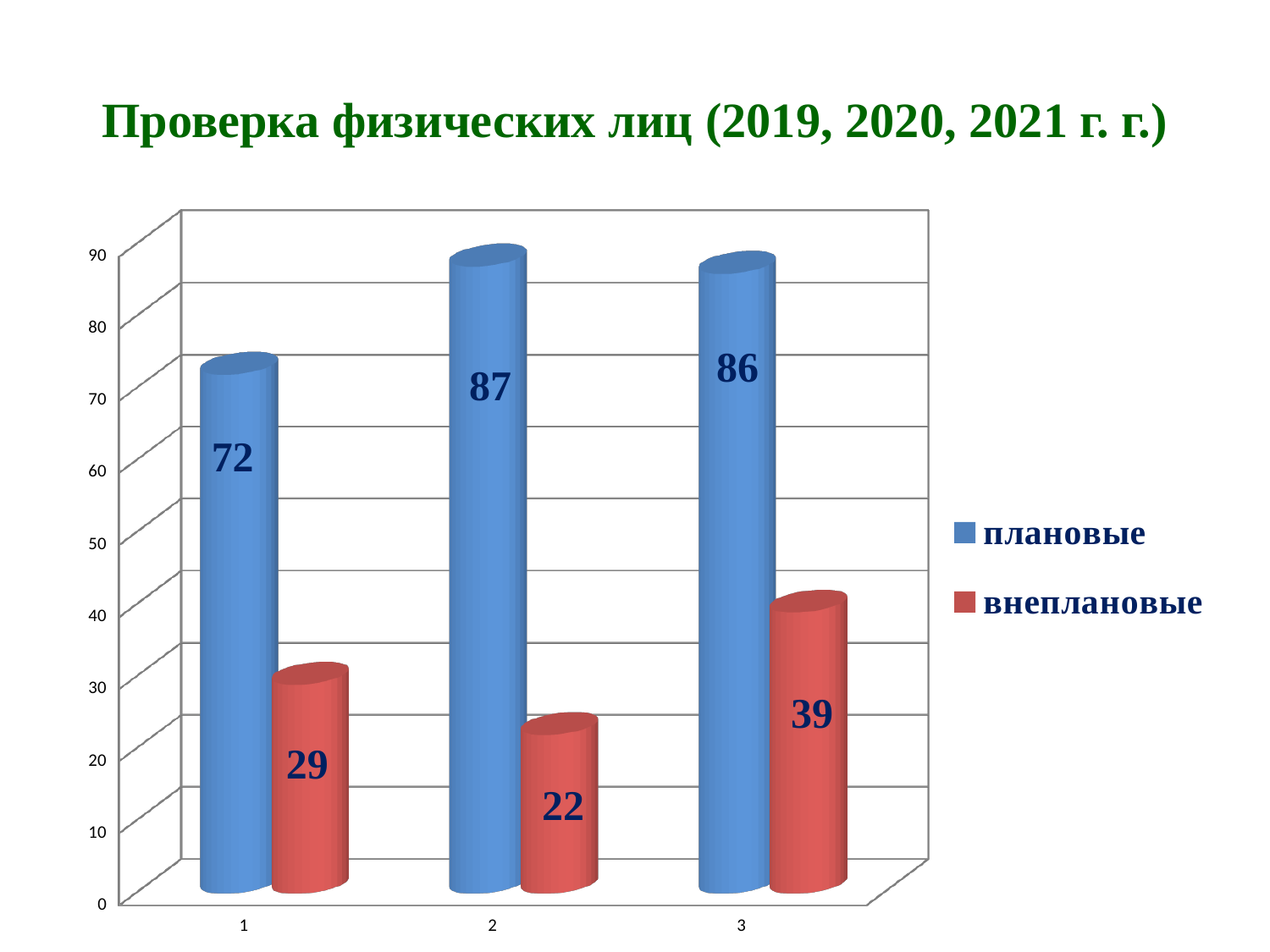
Which category has the highest value for плановые? 2 What is the value of плановые for category 1? 72 What is the difference between the плановые values for category 2 and category 1? 15 What is the title of the slide? Проверка физических лиц (2019, 2020, 2021 г. г.) What is the difference between плановые and внеплановые for category 3? 47 What is the value of внеплановые for category 2? 22 Which category has the lowest value for внеплановые? 2 What is the value of внеплановые for category 3? 39 How many categories are shown on the x axis? 3 Which is larger: внеплановые for category 1 or внеплановые for category 3? внеплановые for category 3 How many series does the legend list? 2 What kind of chart is shown on the slide? bar chart